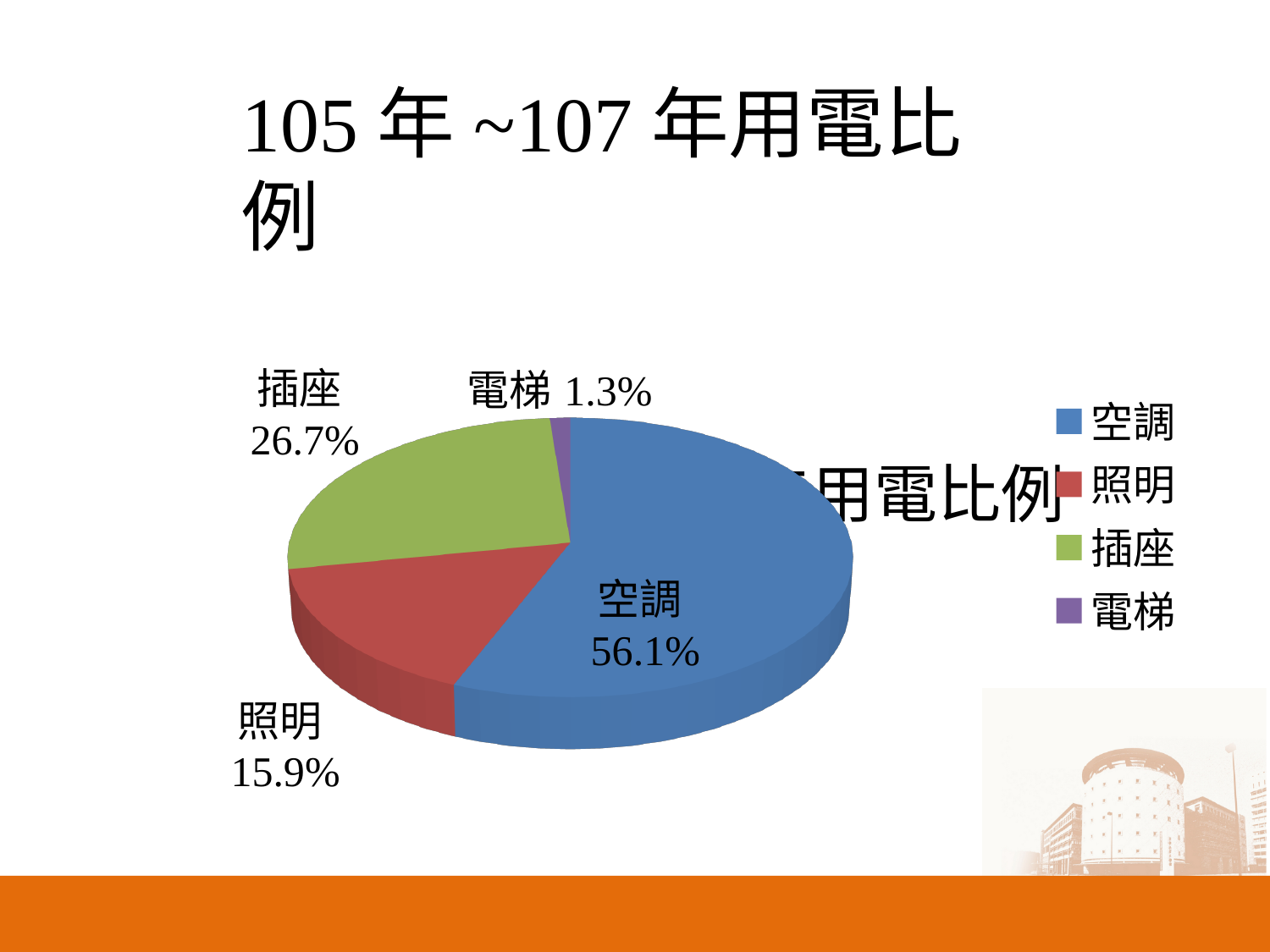
Which colour represents 插座 in the legend? green How many slices does the pie chart have? 4 What is the difference in percentage points between the 照明 share and the 電梯 share? 14.6 What kind of chart is shown on the slide? pie chart What share of electricity use does 插座 account for? 26.7% What share of electricity use does 空調 account for? 56.1% Which category has the smallest share of the pie? 電梯 What share of electricity use does 電梯 account for? 1.3% What is the difference in percentage points between the 空調 share and the 插座 share? 29.4 What share of electricity use does 照明 account for? 15.9% Which category has the largest share of the pie? 空調 Which has a larger share, 插座 or 照明? 插座